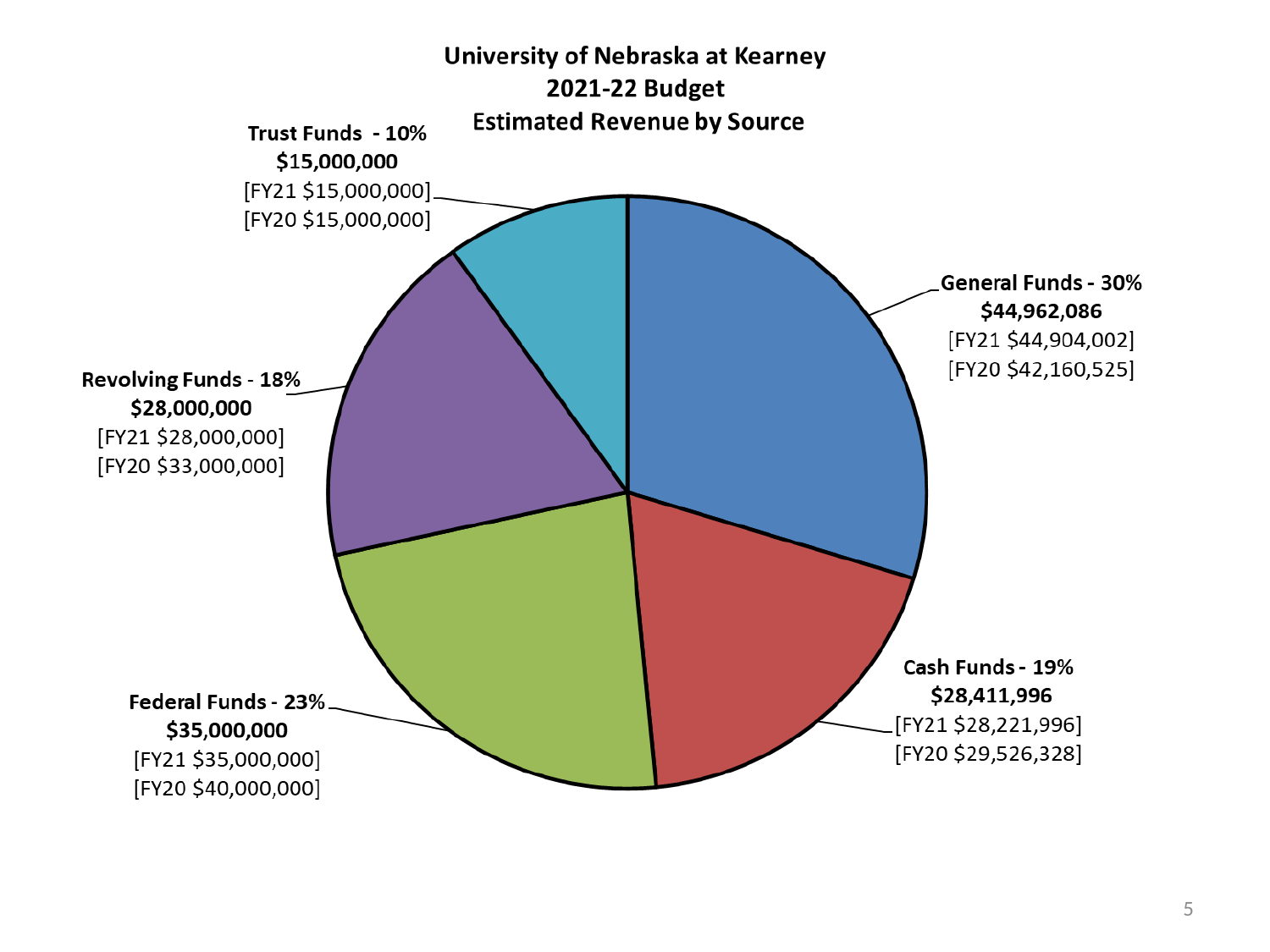
Which revenue source has the smallest share of the pie? Trust Funds Which revenue source has the largest share of the pie? General Funds What is the FY20 value shown for Federal Funds? $40,000,000 What is the difference between the 2021-22 Federal Funds value and the Revolving Funds value? $7,000,000 What is the FY21 value shown for Revolving Funds? $28,000,000 What is the estimated 2021-22 revenue from General Funds? $44,962,086 What is the estimated 2021-22 revenue from Cash Funds? $28,411,996 What share of the pie do Federal Funds represent? 23% Which is larger, the 2021-22 value for Federal Funds or for Cash Funds? Federal Funds How many revenue sources are shown in the pie chart? 5 What share of the pie do Revolving Funds represent? 18% What kind of chart is shown on the slide? pie chart